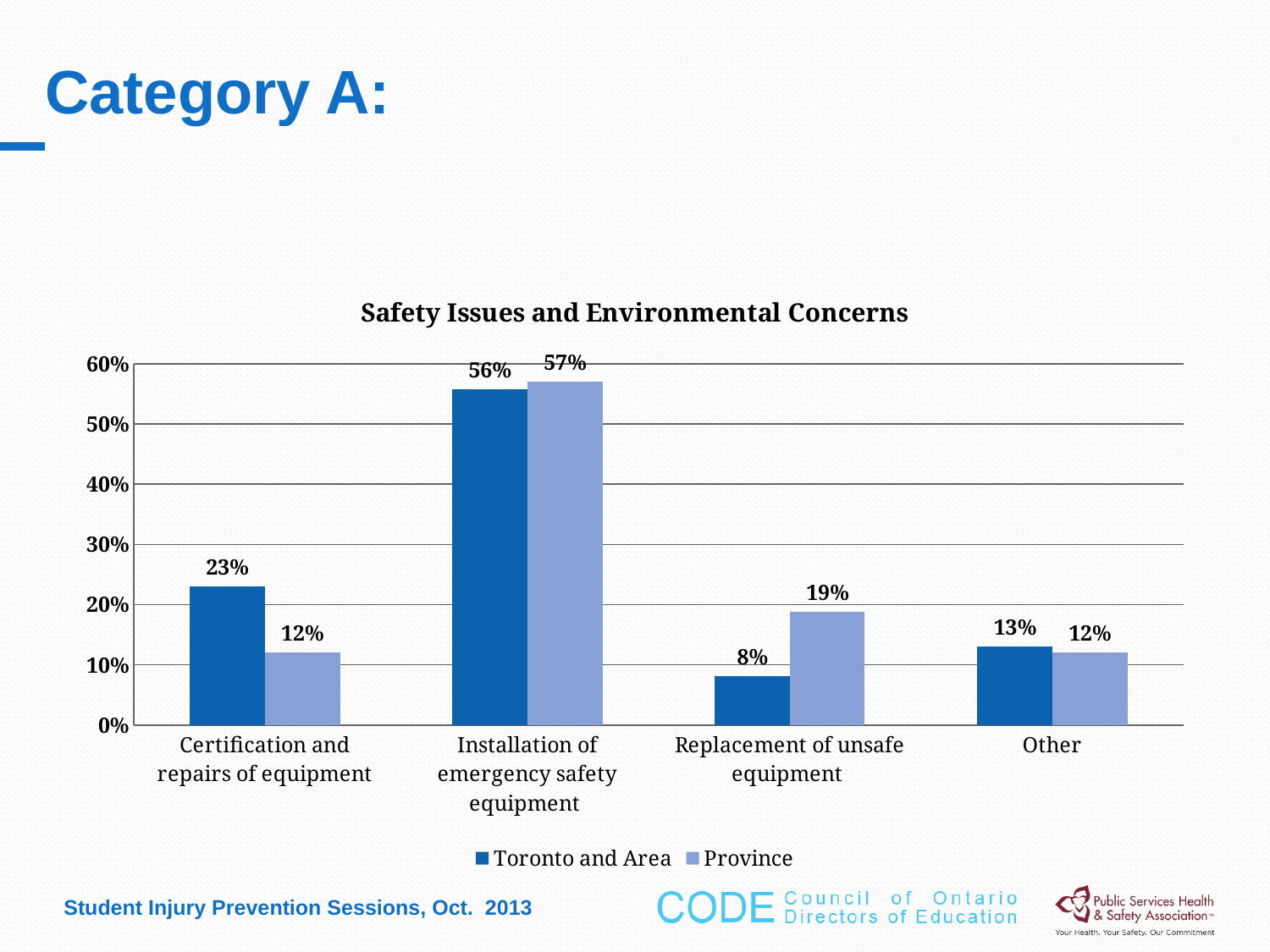
How many series does the legend list? 2 What is the Toronto and Area value for Certification and repairs of equipment? 23% What is the Province value for Installation of emergency safety equipment? 57% Which category has the highest Toronto and Area value? Installation of emergency safety equipment What is the difference between the Toronto and Area and Province values for Certification and repairs of equipment? 11% Which category has the lowest Toronto and Area value? Replacement of unsafe equipment What is the title of the chart? Safety Issues and Environmental Concerns What is the difference between the Province and Toronto and Area values for Replacement of unsafe equipment? 11% What is the Province value for Replacement of unsafe equipment? 19% How many categories are shown on the x axis? 4 For Replacement of unsafe equipment, which series has the larger value, Toronto and Area or Province? Province Is the Toronto and Area value for Installation of emergency safety equipment greater or less than 50%? greater